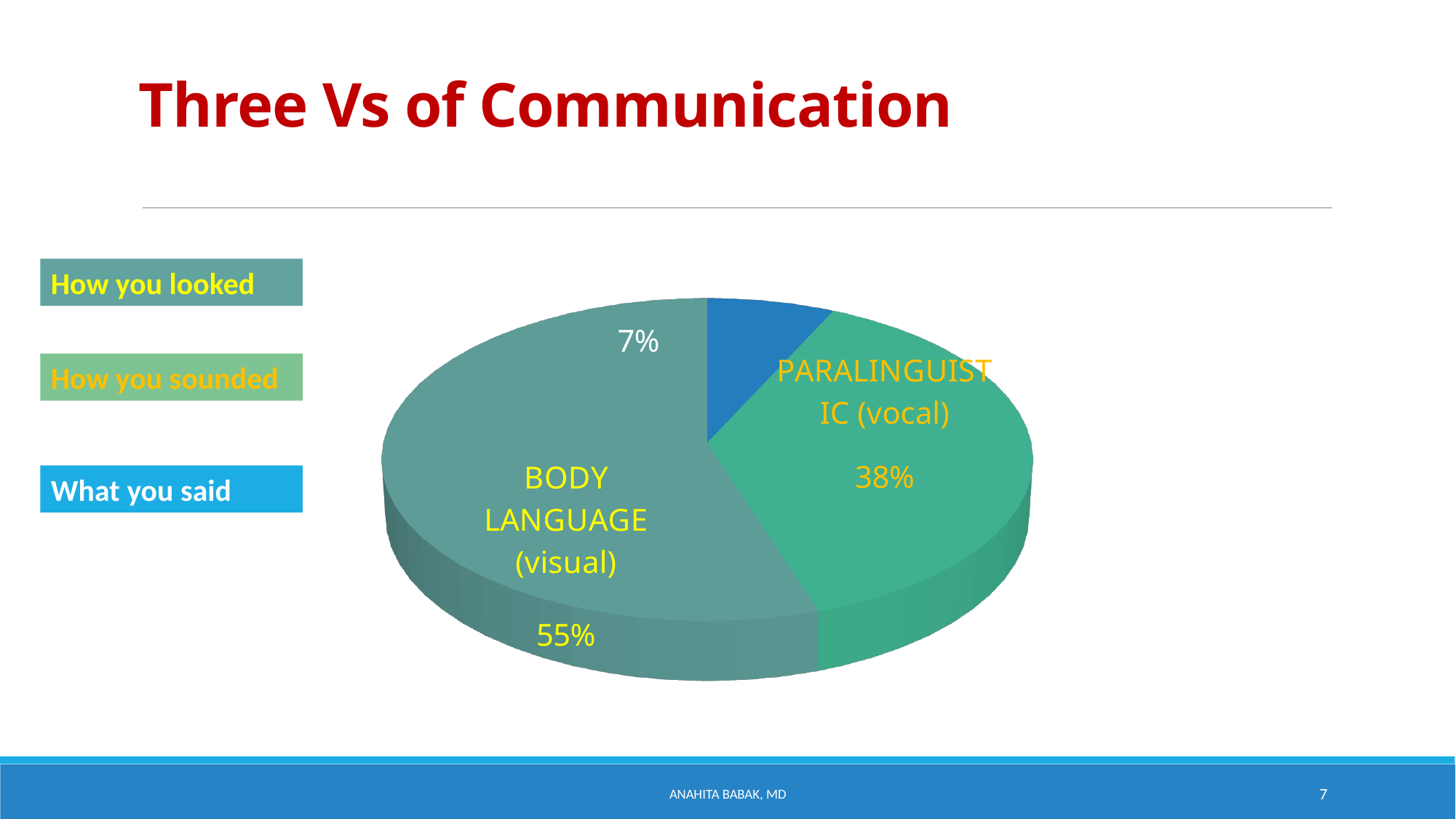
What is the smallest percentage shown on the pie chart? 7% Which slice of the pie is the largest? BODY LANGUAGE (visual) What percentage does the PARALINGUISTIC (vocal) slice represent? 38% What percentage is shown for the small blue slice of the pie? 7% What is the title of the slide containing the pie chart? Three Vs of Communication What kind of chart is shown on the slide? pie chart What percentage does the BODY LANGUAGE (visual) slice represent? 55% How many percentage points larger is PARALINGUISTIC (vocal) than the 7% slice? 31 percentage points What do the three percentages on the pie chart add up to? 100% How many slices does the pie chart have? 3 How many percentage points larger is BODY LANGUAGE (visual) than PARALINGUISTIC (vocal)? 17 percentage points Which is larger, the BODY LANGUAGE (visual) slice or the PARALINGUISTIC (vocal) slice? BODY LANGUAGE (visual)